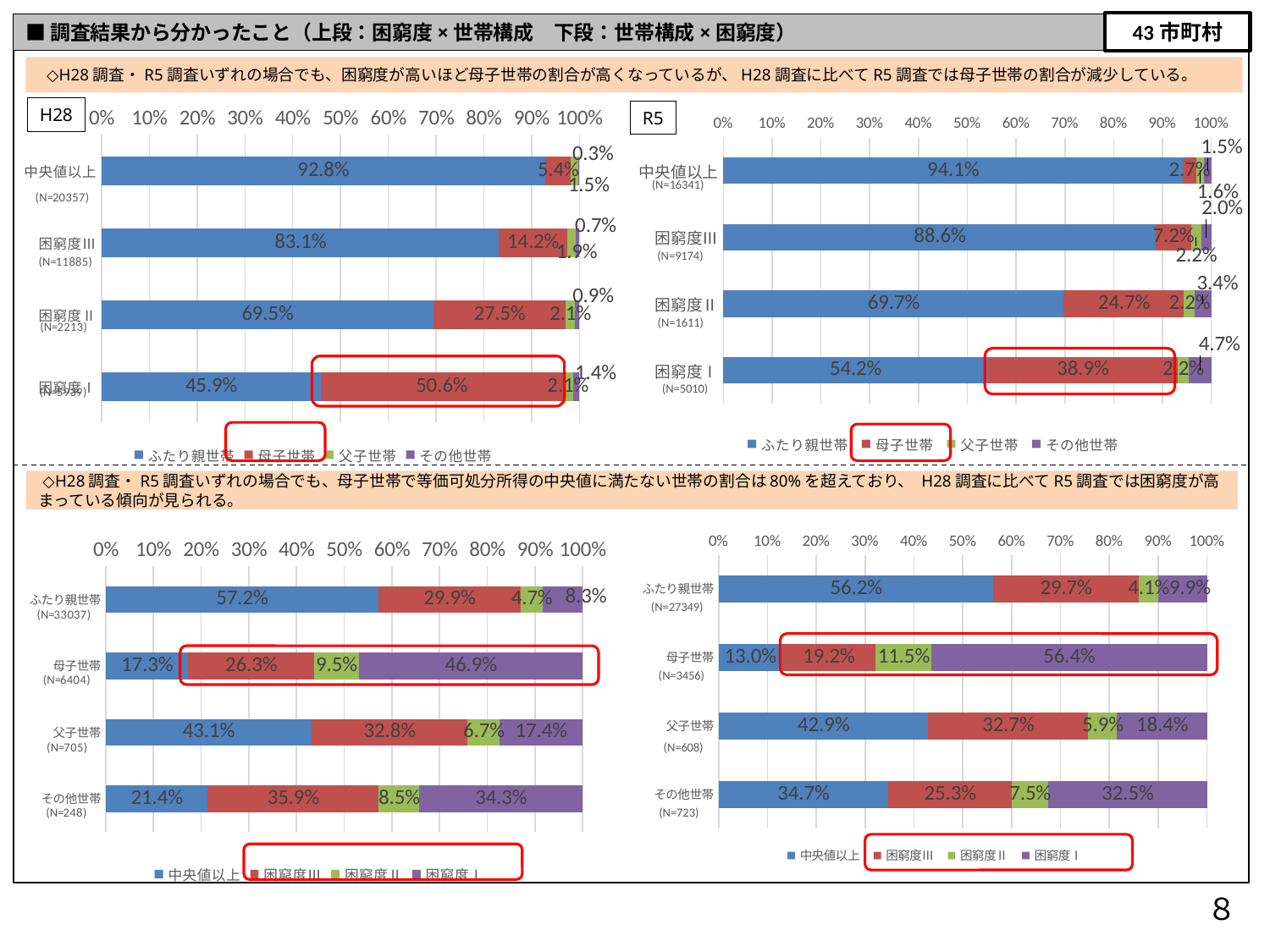
In the bottom-left chart, what is the value of 困窮度Ⅰ for 母子世帯? 46.9% What kind of chart is the bottom-left chart? Stacked bar chart In the top-left H28 chart, what is the difference between the 母子世帯 values for 困窮度Ⅰ and 困窮度Ⅱ? 23.1% How many series does the legend of the bottom-right chart list? 4 In the bottom-left chart, which category has the lowest 中央値以上 value? 母子世帯 In the top-left H28 chart, what is the value of 母子世帯 for 困窮度Ⅰ? 50.6% In the top-left H28 chart, which category has the lowest ふたり親世帯 value? 困窮度Ⅰ In the top-right R5 chart, what is the value of ふたり親世帯 for 中央値以上? 94.1% In the bottom-right chart, what is the value of 困窮度Ⅰ for 母子世帯? 56.4% In the bottom-right chart, which is larger: the 中央値以上 value for ふたり親世帯 or for 父子世帯? ふたり親世帯 How many categories are shown in the top-left H28 chart? 4 In the top-right R5 chart, which category has the highest 母子世帯 value? 困窮度Ⅰ